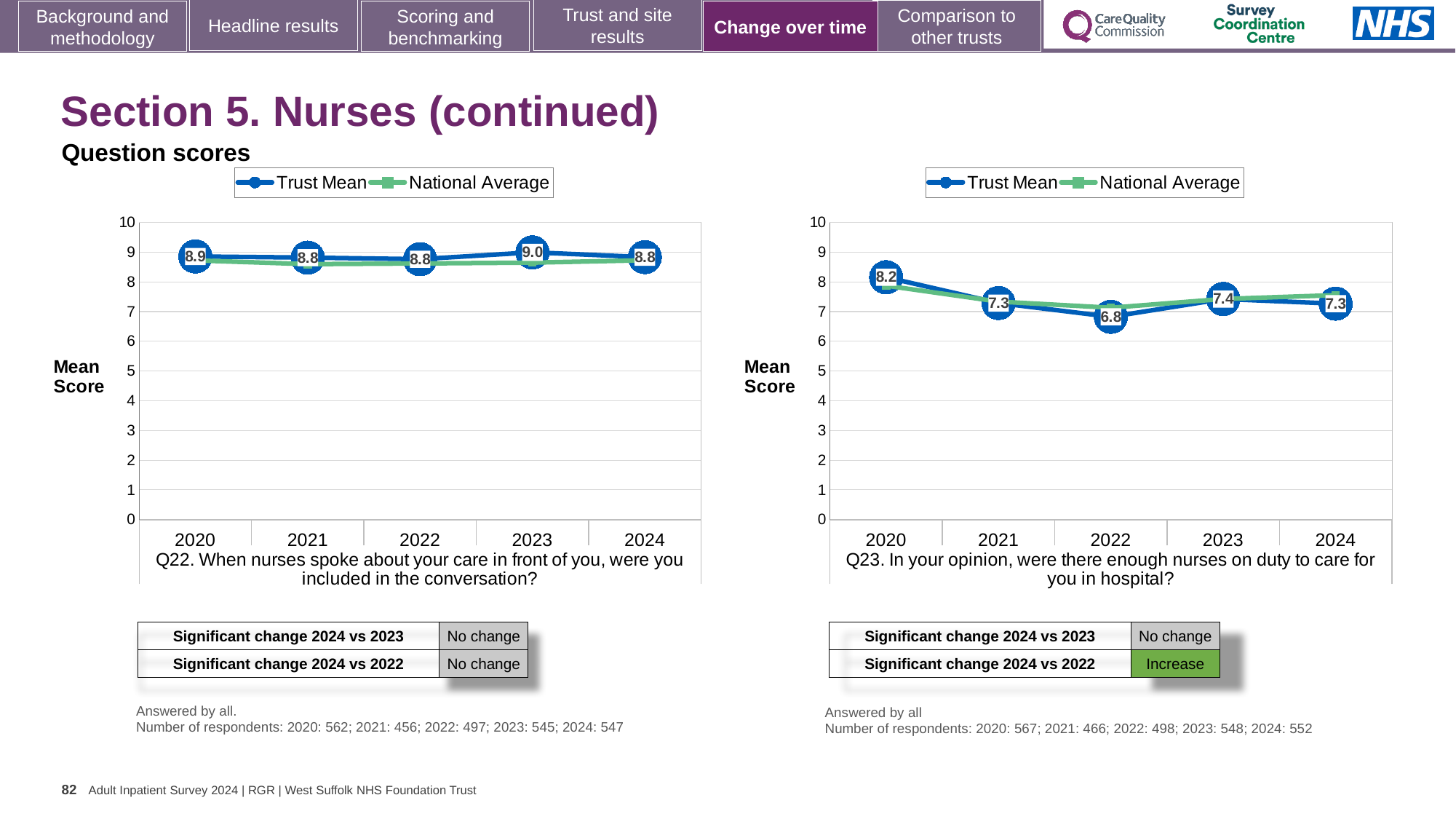
How many years are plotted on the Q22 chart (left)? 5 How many series does the legend of the Q23 chart (right) list? 2 What kind of chart is used for Q22 (left)? Line chart On the Q22 chart (left), what is the Trust Mean score for 2023? 9.0 On the Q23 chart (right), is the Trust Mean value for 2022 greater or less than 7? less On the Q23 chart (right), what is the Trust Mean score for 2020? 8.2 On the Q23 chart (right), which year has the lowest Trust Mean score? 2022 On the Q23 chart (right), what is the difference between the Trust Mean scores for 2020 and 2022? 1.4 On the Q23 chart (right), what is the Trust Mean score for 2022? 6.8 On the Q22 chart (left), which is larger: the Trust Mean score for 2023 or for 2024? 2023 On the Q22 chart (left), what is the Trust Mean score for 2020? 8.9 On the Q23 chart (right), which year has the highest Trust Mean score? 2020